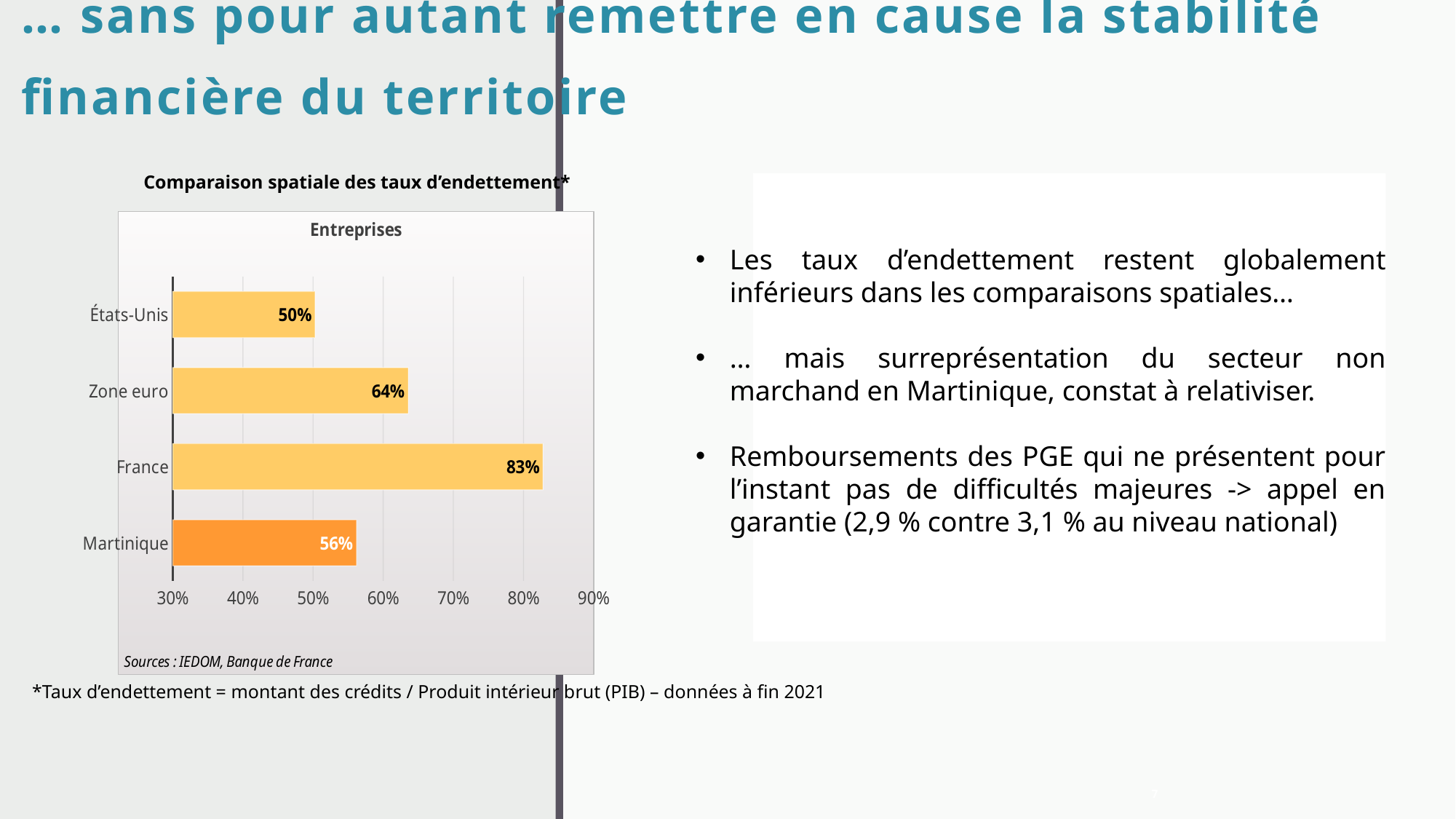
Which is larger, the value for Zone euro or the value for Martinique? Zone euro What kind of chart is shown? bar chart What is the value for Martinique? 56% What is the value for France? 83% Is the value for France greater or less than 80%? greater What is the value for États-Unis? 50% Which category has the lowest value? États-Unis How many categories are shown in the chart? 4 What is the title of the chart? Comparaison spatiale des taux d’endettement* What is the value for Zone euro? 64% What is the difference between the values for France and Martinique? 27% Which category has the highest value? France